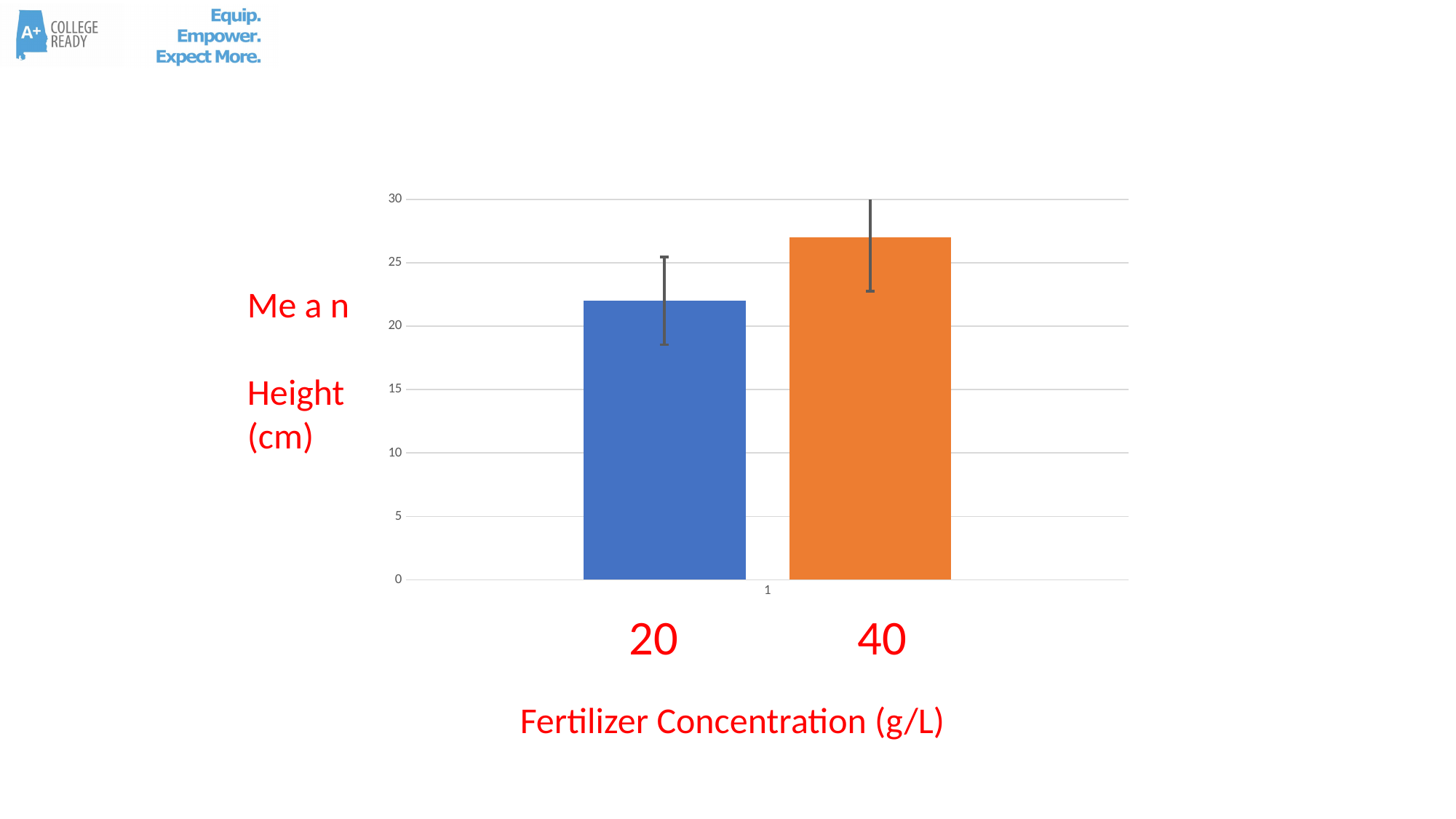
What kind of chart is shown on the slide? bar chart Which fertilizer concentration has the lowest mean height? 20 Is the mean height for the 40 g/L fertilizer concentration greater or less than 25? greater Is the mean height for the 20 g/L fertilizer concentration greater or less than 20? greater How many bars are plotted in the chart? 2 Is the mean height for the 20 g/L fertilizer concentration greater or less than 25? less What colour is the bar for the 40 g/L fertilizer concentration? orange What is the label on the x axis of the chart? Fertilizer Concentration (g/L) Which fertilizer concentration has the higher mean height, 20 g/L or 40 g/L? 40 Does the mean height rise or fall as fertilizer concentration increases from 20 to 40 g/L? rise Which fertilizer concentration has the highest mean height? 40